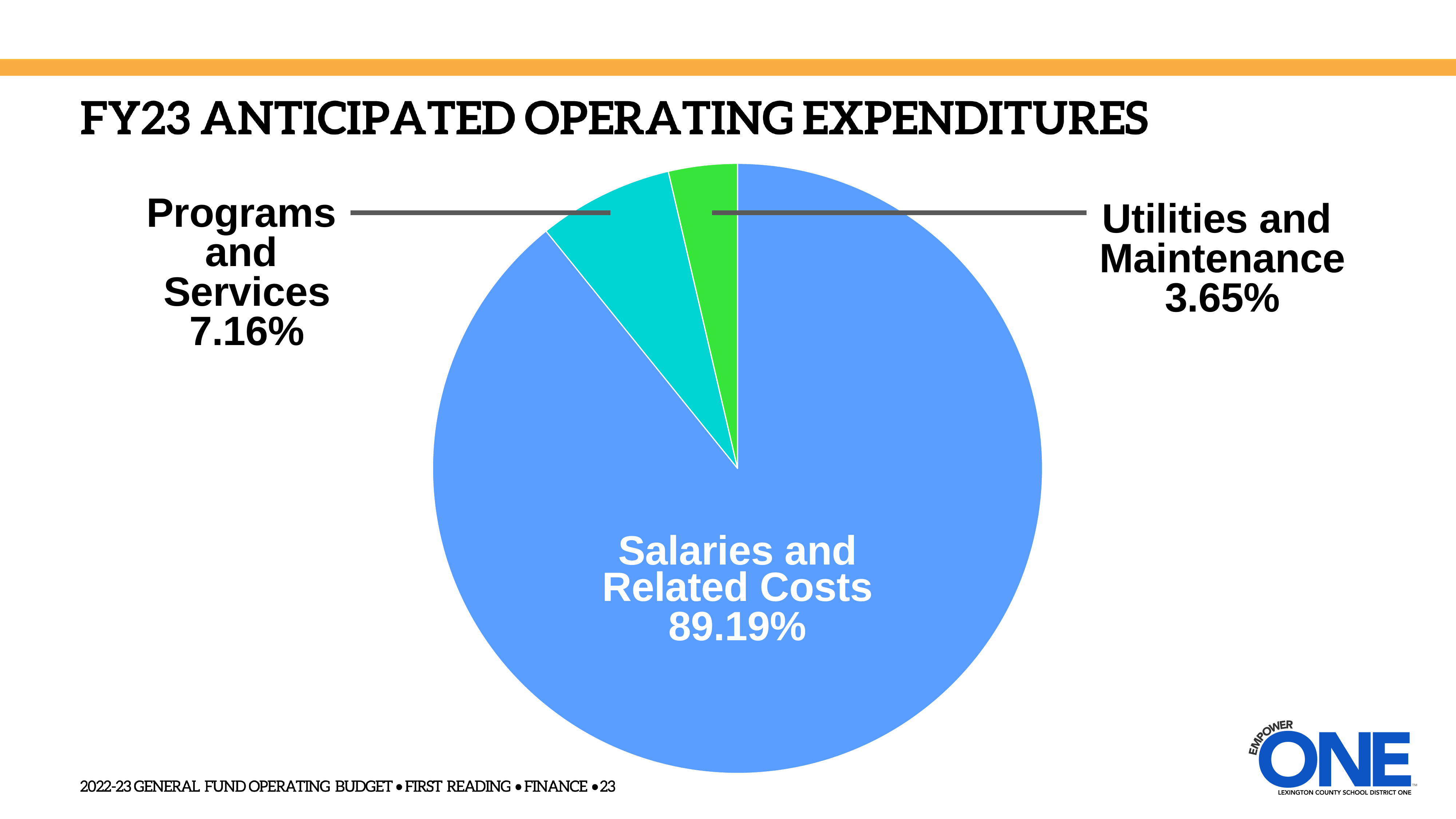
What is the combined share of Programs and Services and Utilities and Maintenance? 10.81% What share of FY23 anticipated operating expenditures is Salaries and Related Costs? 89.19% How many slices does the pie chart have? 3 What colour is the Salaries and Related Costs slice? Blue What is the difference in percentage points between Programs and Services and Utilities and Maintenance? 3.51 What is the title of the chart? FY23 ANTICIPATED OPERATING EXPENDITURES Which is larger, the share for Programs and Services or the share for Utilities and Maintenance? Programs and Services What percentage of the pie is Programs and Services? 7.16% What kind of chart is shown on the slide? Pie chart Which category has the smallest share of the pie? Utilities and Maintenance What percentage of the pie is Utilities and Maintenance? 3.65% Which category has the largest share of the pie? Salaries and Related Costs